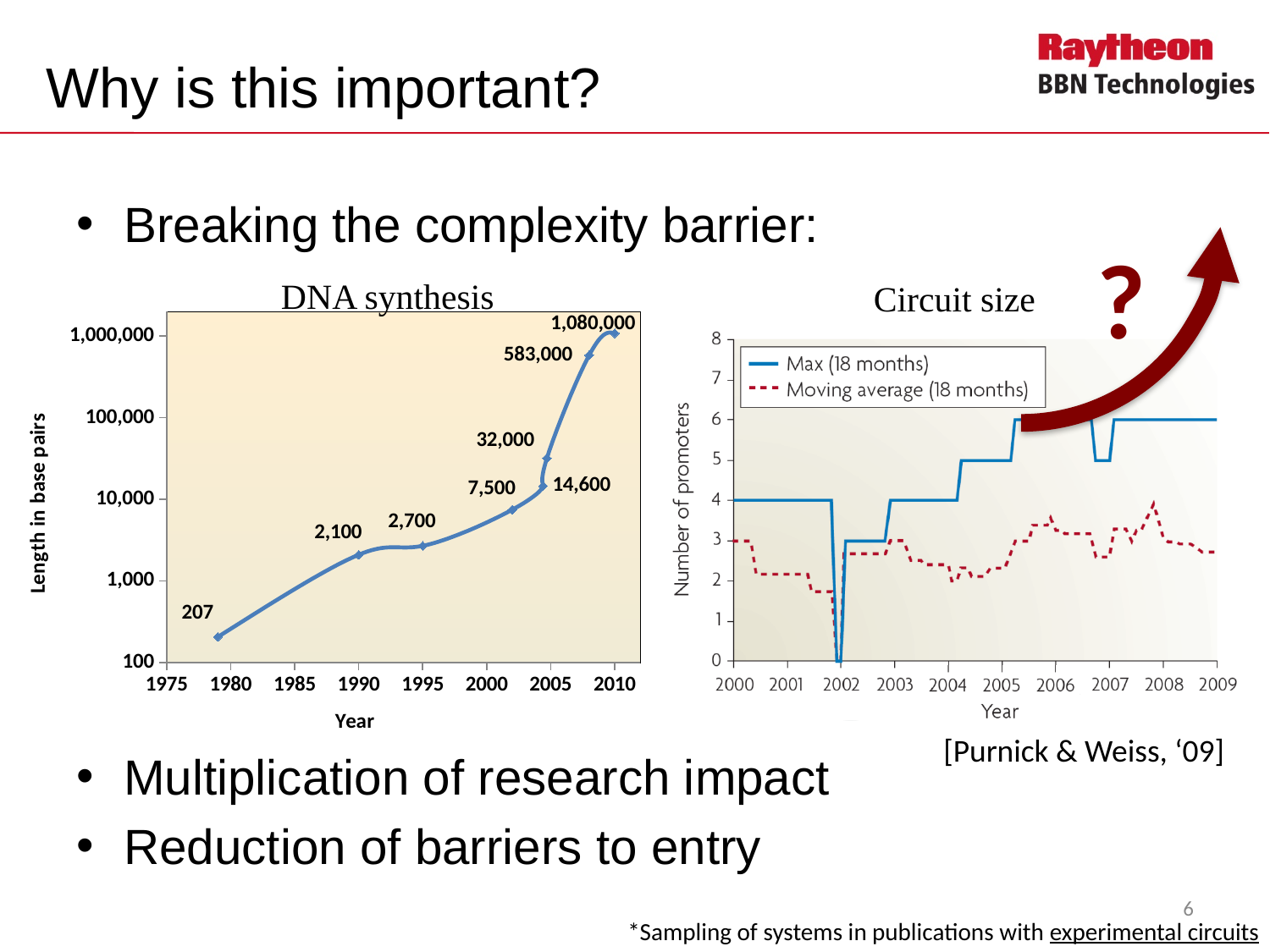
What kind of chart is the Circuit size chart? line chart In the DNA synthesis chart, what is the difference between the labeled values 2,700 and 2,100? 600 In the Circuit size chart, is the Max (18 months) value in 2006 greater or less than 4? greater What is the y-axis label of the DNA synthesis chart? Length in base pairs In the DNA synthesis chart, do the values rise or fall as the year increases? rise In the DNA synthesis chart, what is the highest labeled value? 1,080,000 In the DNA synthesis chart, what is the lowest labeled value? 207 In the DNA synthesis chart, what is the labeled value for the point at 1995? 2,700 How many series does the legend of the Circuit size chart list? 2 In the Circuit size chart, which series is higher in 2008, Max (18 months) or Moving average (18 months)? Max (18 months) In the Circuit size chart, what is the value of Max (18 months) in 2009? 6 In the DNA synthesis chart, how many data points have value labels? 8